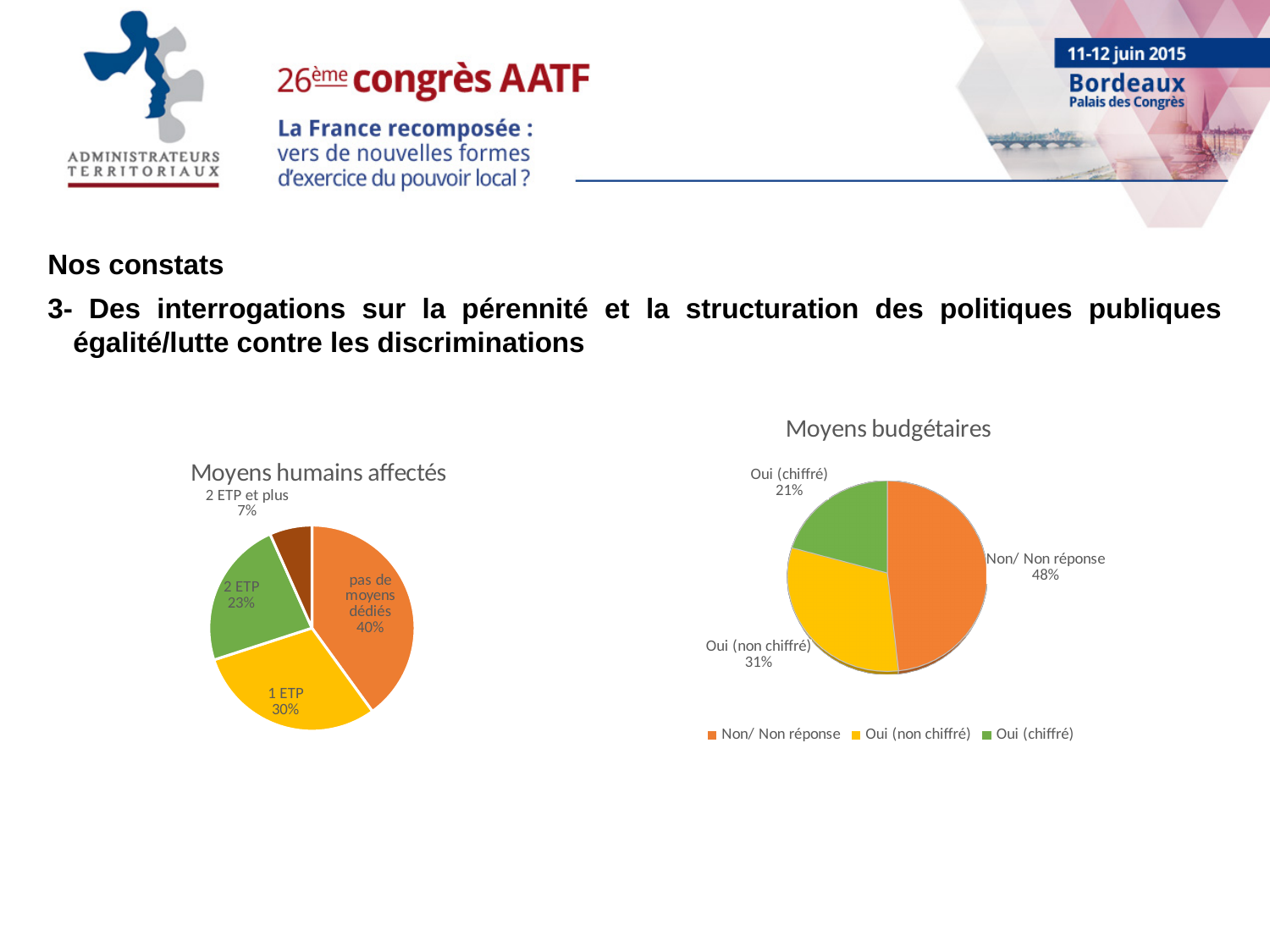
In the 'Moyens humains affectés' chart, which category has the largest slice? pas de moyens dédiés In the 'Moyens budgétaires' chart, what share is labelled for 'Non/ Non réponse'? 48% In the 'Moyens budgétaires' chart, which is larger: 'Oui (non chiffré)' or 'Oui (chiffré)'? Oui (non chiffré) In the 'Moyens budgétaires' chart, which category has the largest slice? Non/ Non réponse In the 'Moyens humains affectés' chart, what share is labelled for '1 ETP'? 30% In the 'Moyens humains affectés' chart, which category has the smallest slice? 2 ETP et plus In the 'Moyens humains affectés' chart, what share is labelled for 'pas de moyens dédiés'? 40% In the 'Moyens budgétaires' chart, how many entries does the legend list? 3 What type of chart is the 'Moyens budgétaires' chart? Pie chart In the 'Moyens humains affectés' chart, how many slices does the pie have? 4 In the 'Moyens humains affectés' chart, what is the difference in percentage points between '2 ETP' and '2 ETP et plus'? 16 In the 'Moyens budgétaires' chart, what share is labelled for 'Oui (chiffré)'? 21%